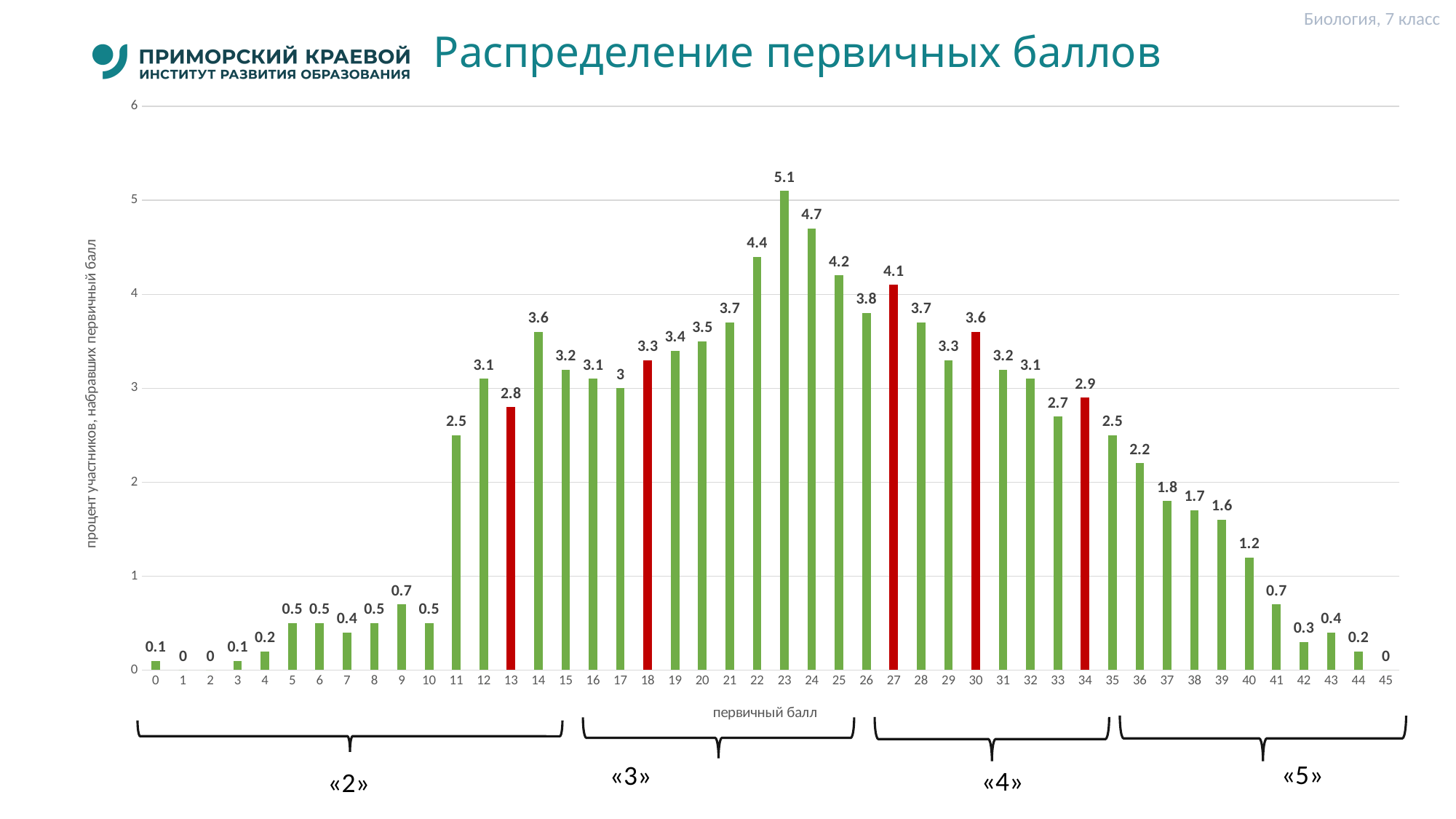
What is the value for primary score 23? 5.1 Which primary score has the highest percentage of participants? 23 What is the title of the chart? Распределение первичных баллов What is the value for primary score 40? 1.2 Is the value for primary score 22 greater or less than 4? greater What is the value for primary score 13? 2.8 How many primary score categories are shown on the x axis? 46 What kind of chart is shown on the slide? bar chart Do the values rise or fall along the x axis from primary score 23 to 45? fall Which has a larger value, primary score 14 or primary score 15? 14 What is the difference between the values for primary scores 23 and 24? 0.4 How many bars are coloured red? 5